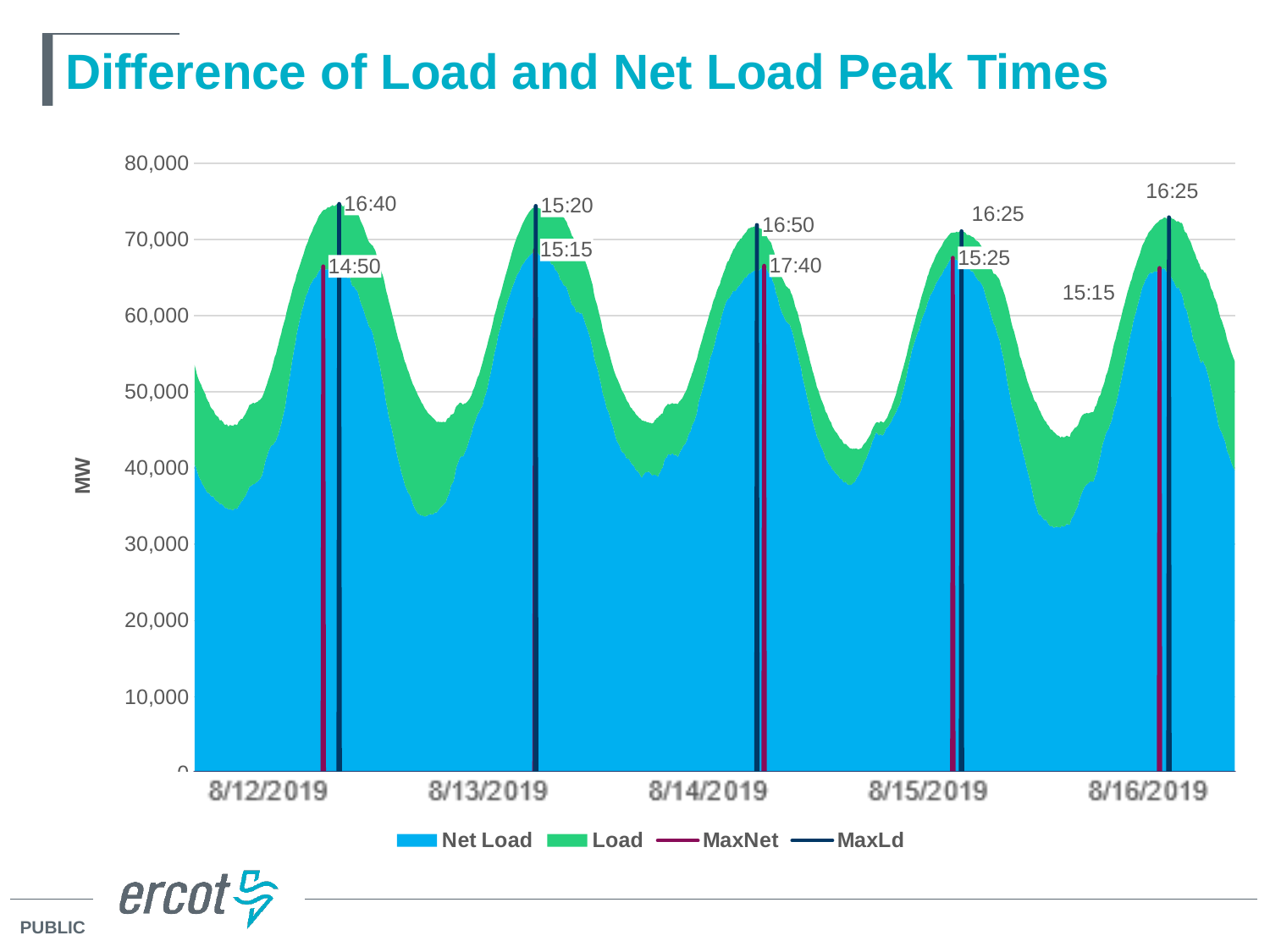
How many series does the legend list? 4 What is the MaxLd peak time labelled for 8/13/2019? 15:20 How many dates are labelled on the x axis? 5 What is the label on the vertical axis? MW What is the MaxNet peak time labelled for 8/15/2019? 15:25 Is the peak Load value on 8/12/2019 greater or less than 70,000 MW? greater What is the MaxLd peak time labelled for 8/16/2019? 16:25 What kind of chart is shown on the slide? Area chart What is the MaxNet peak time labelled for 8/12/2019? 14:50 What is the MaxLd peak time labelled for 8/12/2019? 16:40 Is the peak Net Load value on 8/14/2019 greater or less than 70,000 MW? less What is the MaxNet peak time labelled for 8/14/2019? 17:40